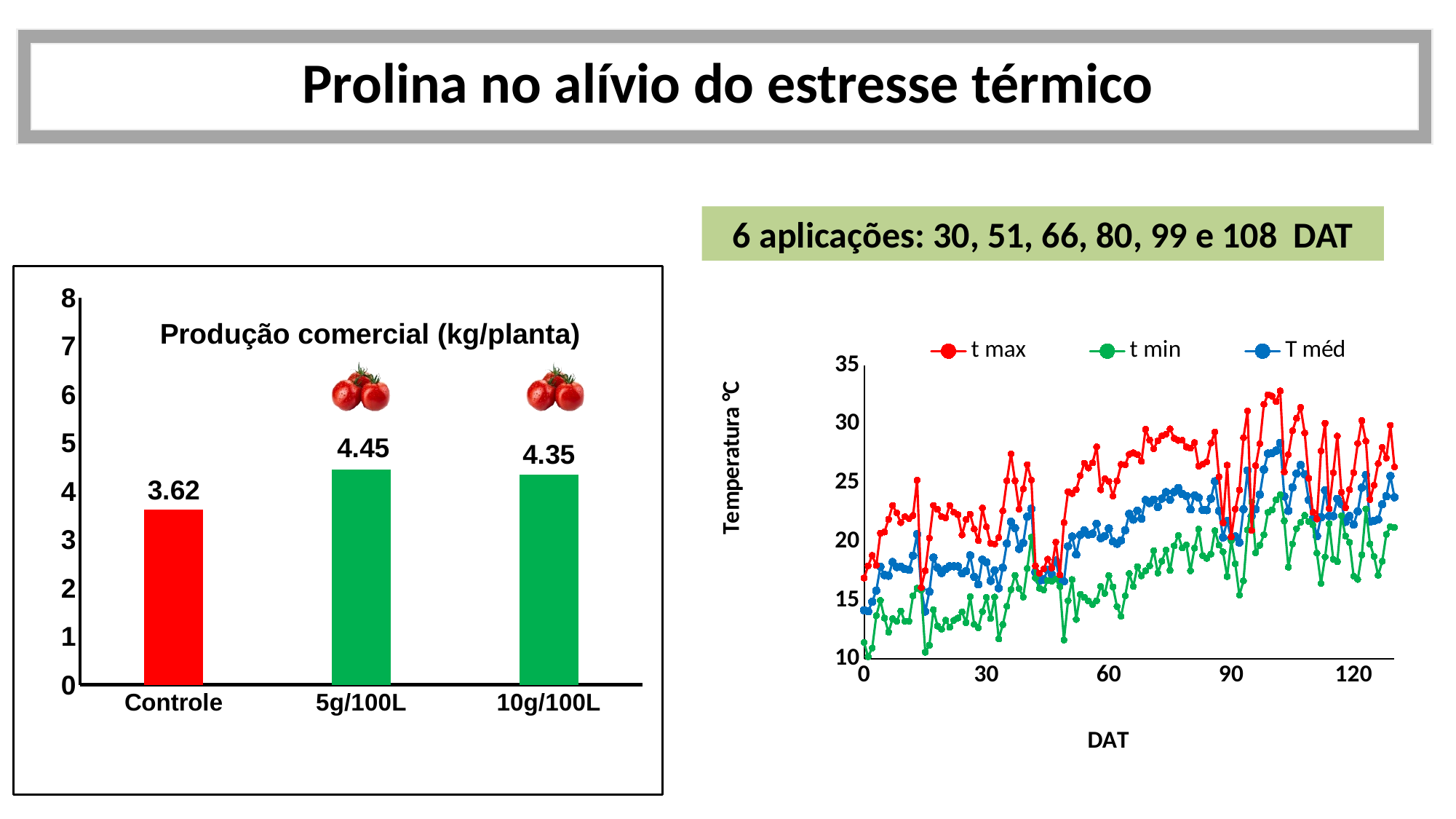
What kind of chart is the temperature chart on the right? line chart In the 'Produção comercial (kg/planta)' chart, what is the value for Controle? 3.62 In the 'Produção comercial (kg/planta)' chart, what is the difference between the values for 5g/100L and Controle? 0.83 In the 'Produção comercial (kg/planta)' chart, what is the value for 5g/100L? 4.45 In the 'Produção comercial (kg/planta)' chart, what is the value for 10g/100L? 4.35 In the temperature chart on the right, what is the label of the y axis? Temperatura °C In the 'Produção comercial (kg/planta)' chart, which is larger, the value for 10g/100L or the value for Controle? 10g/100L In the 'Produção comercial (kg/planta)' chart, how many categories are shown? 3 What kind of chart is the 'Produção comercial (kg/planta)' chart? bar chart In the 'Produção comercial (kg/planta)' chart, which category has the lowest value? Controle In the temperature chart on the right, how many series does the legend list? 3 In the 'Produção comercial (kg/planta)' chart, which category has the highest value? 5g/100L